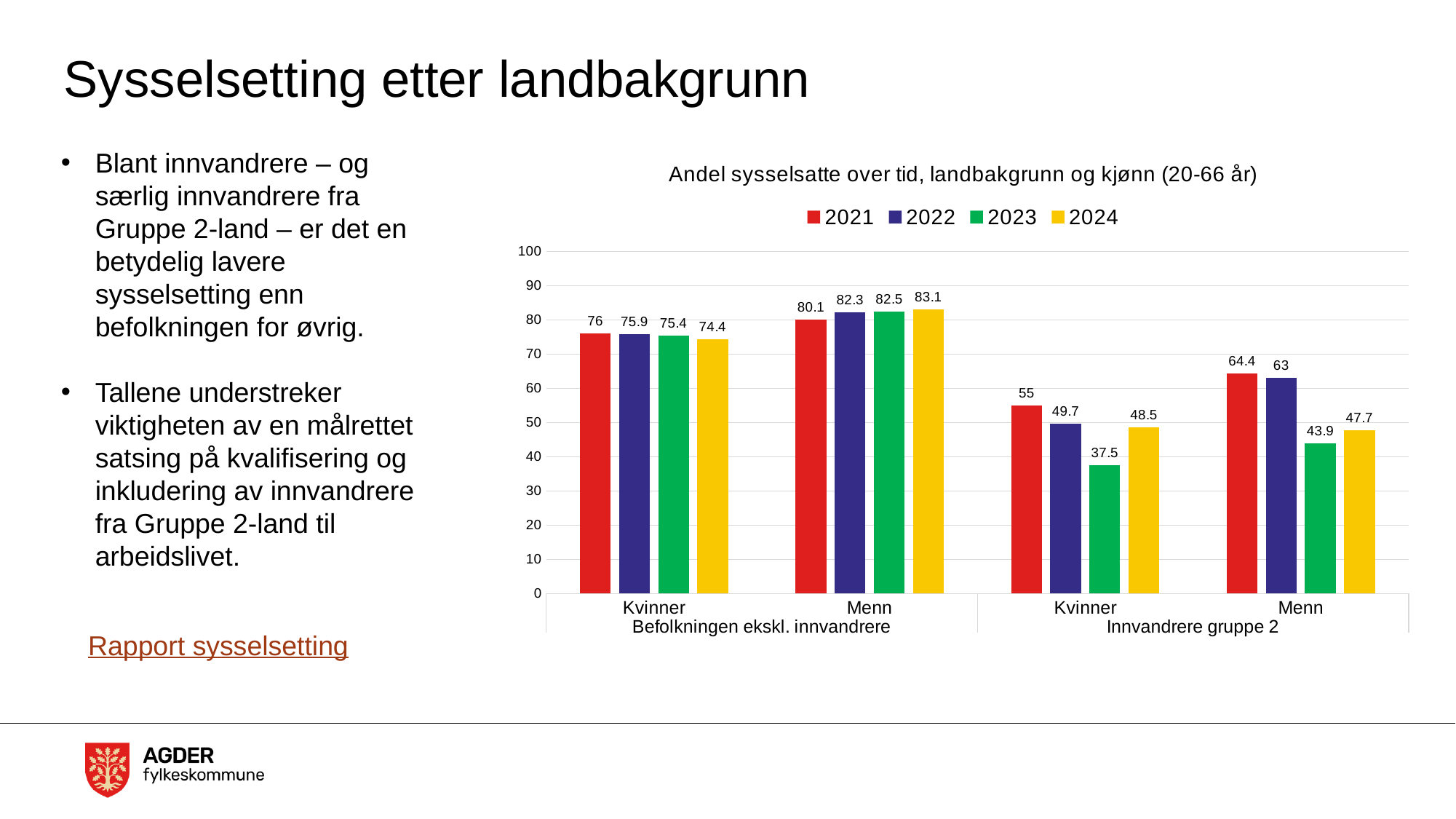
Which is larger: the 2024 value for Kvinner in Innvandrere gruppe 2 or the 2024 value for Menn in Innvandrere gruppe 2? Kvinner in Innvandrere gruppe 2 (48.5) Which year has the lowest value for Kvinner in the Innvandrere gruppe 2 group? 2023 Which year has the highest value for Menn in the Befolkningen ekskl. innvandrere group? 2024 What kind of chart is shown on the slide? bar chart What is the 2021 value for Menn in the Innvandrere gruppe 2 group? 64.4 Do the values for Kvinner in the Befolkningen ekskl. innvandrere group rise or fall from 2021 to 2024? fall What is the difference between the 2021 and 2023 values for Menn in the Innvandrere gruppe 2 group? 20.5 What is the 2024 value for Menn in the Befolkningen ekskl. innvandrere group? 83.1 What is the 2023 value for Kvinner in the Innvandrere gruppe 2 group? 37.5 What is the title of the chart? Andel sysselsatte over tid, landbakgrunn og kjønn (20-66 år) How many series does the legend list? 4 Is the 2022 value for Kvinner in the Innvandrere gruppe 2 group greater or less than 60? less